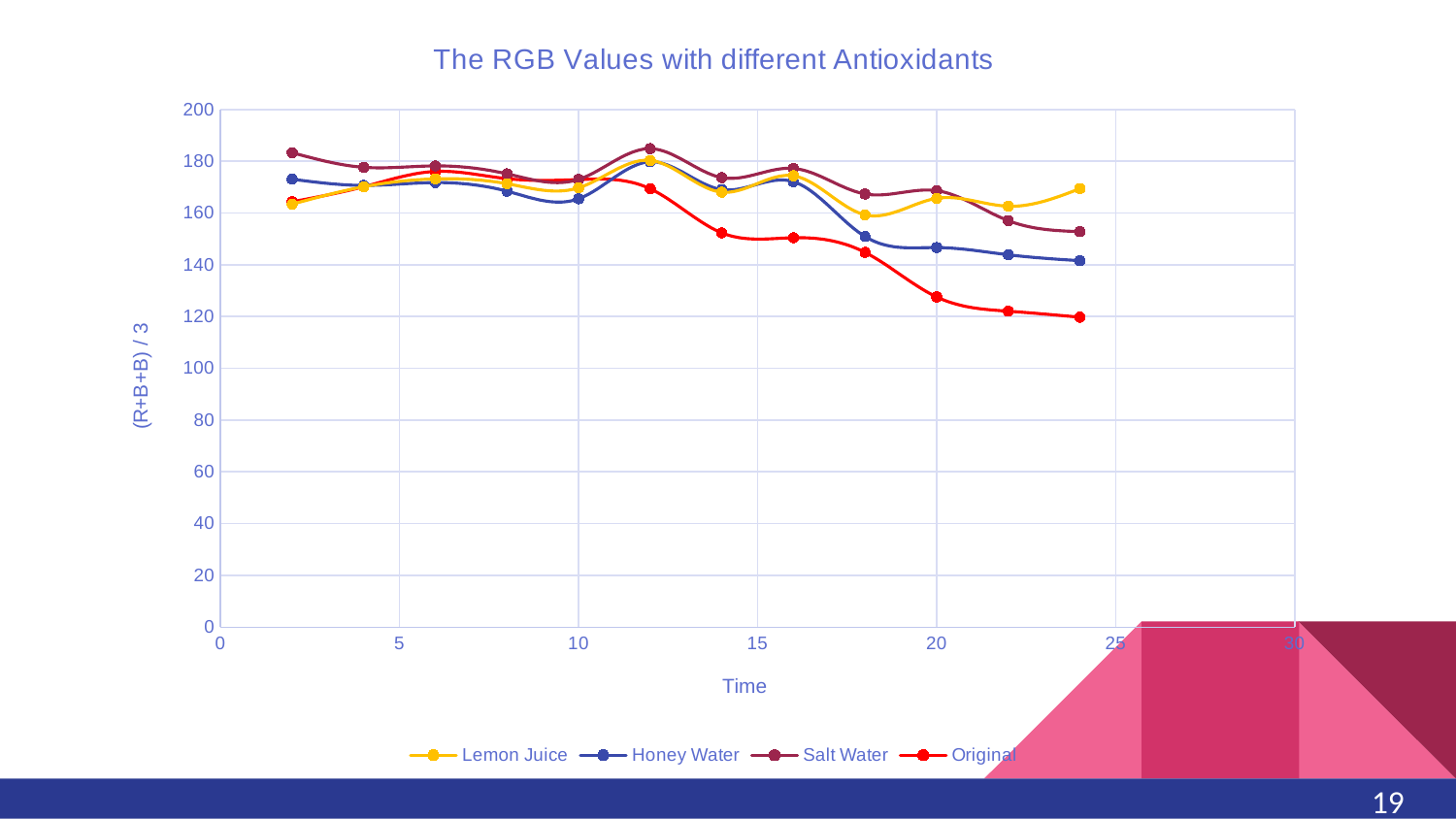
Is the value for Salt Water at time 2 greater or less than 180? greater What is the title of the chart? The RGB Values with different Antioxidants How many series does the legend list? 4 Which series has the highest value at time 24? Lemon Juice Is the value for Original at time 24 greater or less than 140? less Is the value for Honey Water at time 24 greater or less than 160? less What is the label of the y axis? (R+B+B) / 3 How many data points are plotted for the Original series? 12 Which series has the lowest value at time 24? Original Do the values for the Original series rise or fall overall from time 2 to time 24? fall What kind of chart is shown on the slide? line chart